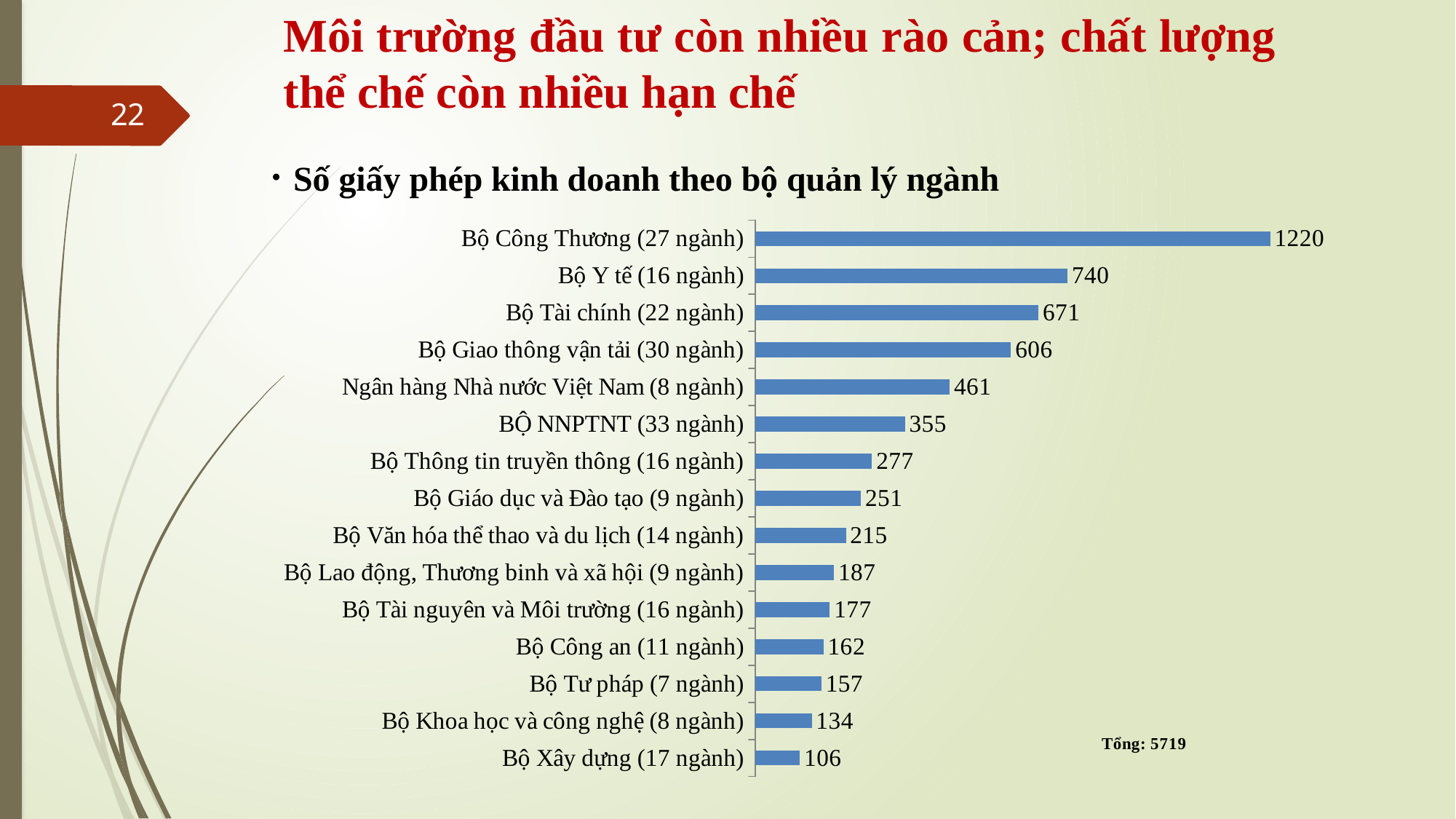
Which is larger, the value for Bộ Giao thông vận tải (30 ngành) or the value for BỘ NNPTNT (33 ngành)? Bộ Giao thông vận tải (30 ngành) What is the value for Bộ Khoa học và công nghệ (8 ngành)? 134 What is the value for Bộ Công Thương (27 ngành)? 1220 What is the value for Bộ Tư pháp (7 ngành)? 157 How many categories are shown in the chart? 15 What is the value for Ngân hàng Nhà nước Việt Nam (8 ngành)? 461 What total is printed on the chart? Tổng: 5719 What is the difference between the values for Bộ Công Thương (27 ngành) and Bộ Xây dựng (17 ngành)? 1114 Which category has the highest value? Bộ Công Thương (27 ngành) Which category has the lowest value? Bộ Xây dựng (17 ngành) What kind of chart is shown on the slide? Bar chart What is the difference between the values for Bộ Y tế (16 ngành) and Bộ Tài chính (22 ngành)? 69